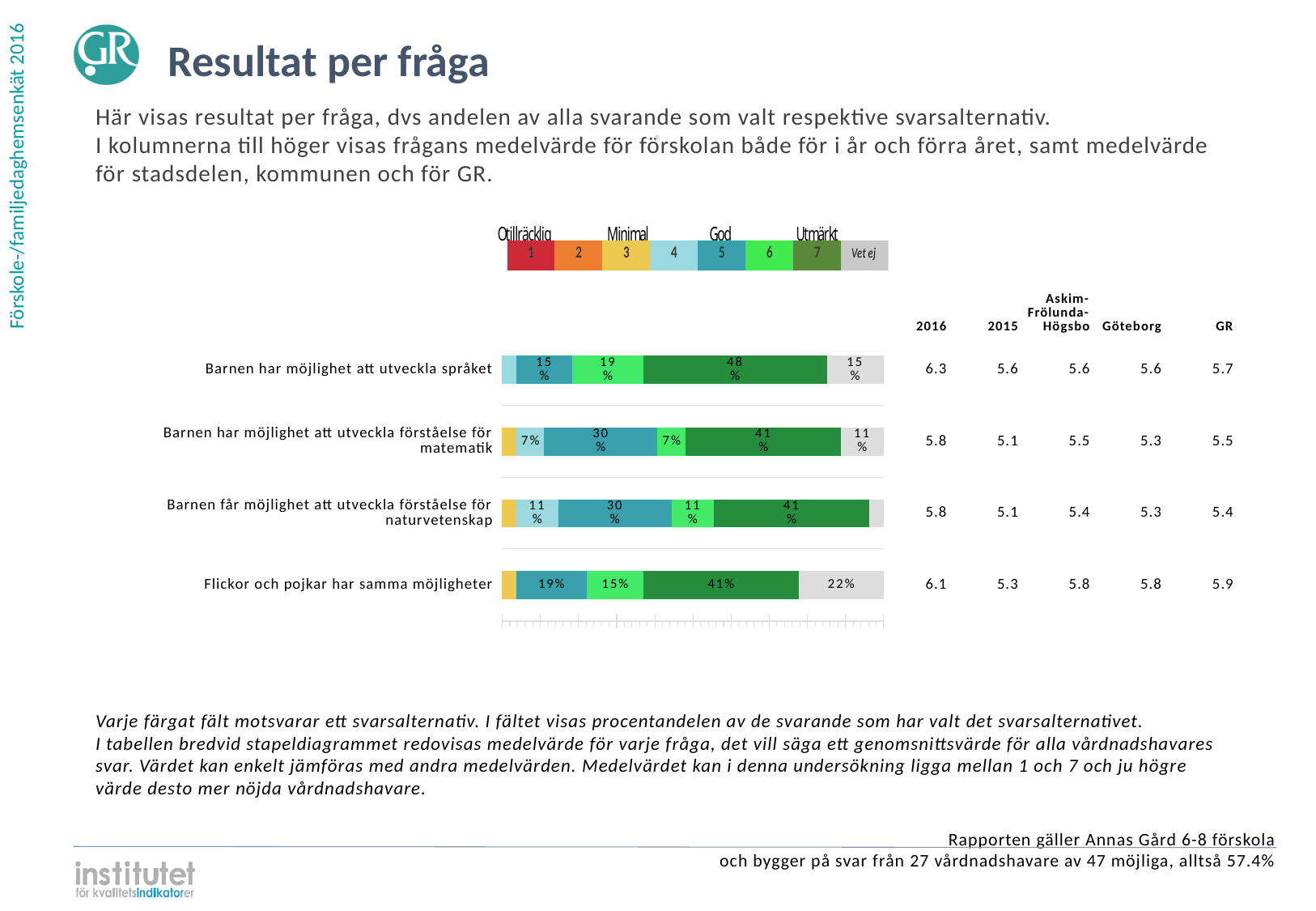
What percentage of respondents chose answer 6 for 'Barnen får möjlighet att utveckla förståelse för naturvetenskap'? 11% What percentage of respondents chose answer 5 for 'Barnen har möjlighet att utveckla förståelse för matematik'? 30% How many questions (bars) are shown in the chart? 4 What is the GR mean value for 'Barnen har möjlighet att utveckla språket'? 5.7 What is the 2016 mean value for 'Flickor och pojkar har samma möjligheter'? 6.1 Which question has the highest share of respondents choosing 'Utmärkt' (7)? Barnen har möjlighet att utveckla språket What percentage of respondents answered 'Vet ej' for 'Flickor och pojkar har samma möjligheter'? 22% What are the four labelled rating levels shown in the legend above the chart? Otillräcklig, Minimal, God, Utmärkt Which is larger: the 'Vet ej' share for 'Flickor och pojkar har samma möjligheter' or for 'Barnen har möjlighet att utveckla språket'? Flickor och pojkar har samma möjligheter What kind of chart is used to show the results per question? Stacked bar chart What is the difference between the 'Utmärkt' (7) share for 'Barnen har möjlighet att utveckla språket' and for 'Flickor och pojkar har samma möjligheter'? 7 percentage points What percentage of respondents chose 'Utmärkt' (7) for 'Barnen har möjlighet att utveckla språket'? 48%